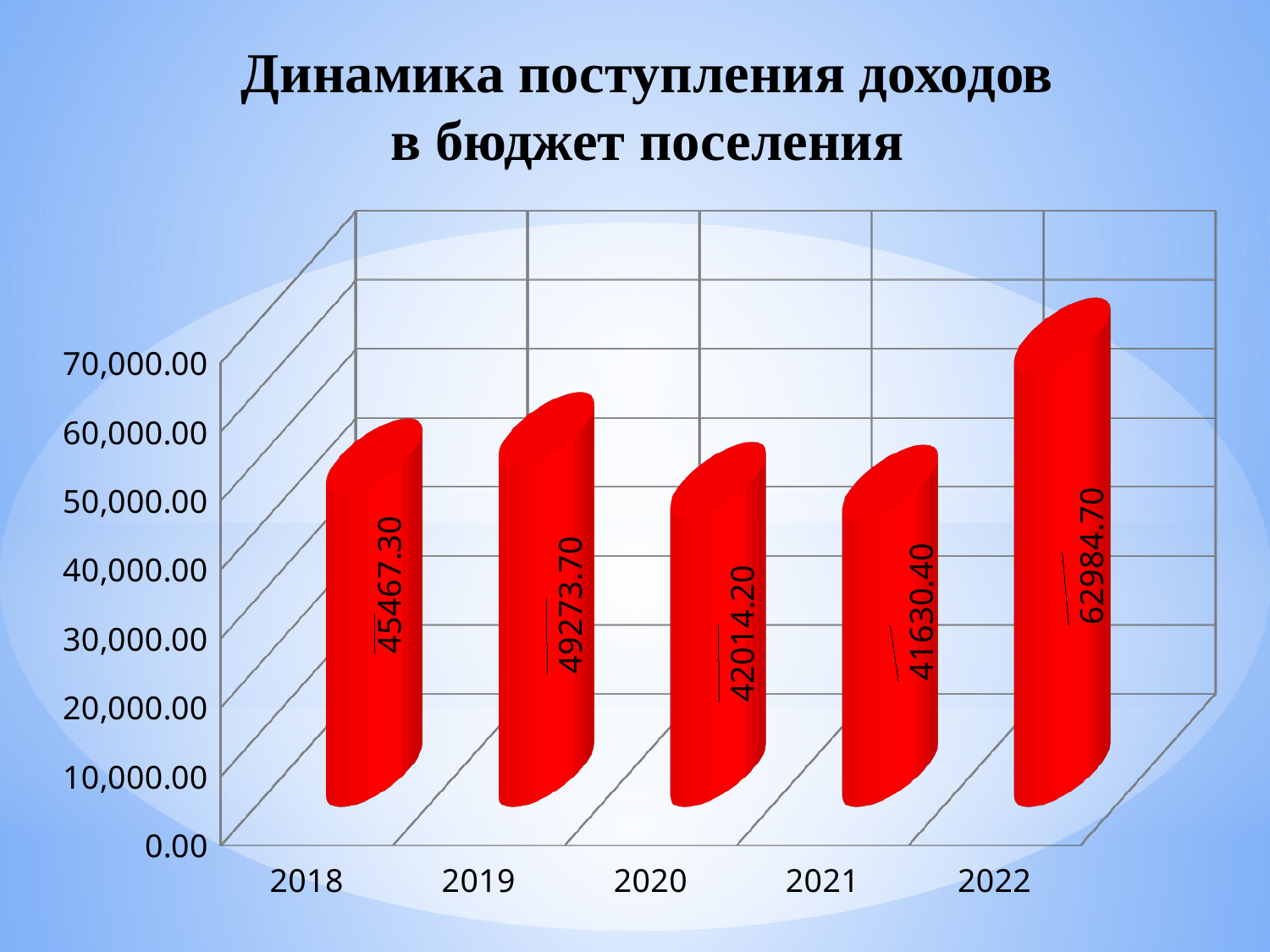
Between 2019 and 2021, do the values rise or fall? fall What is the difference between the values for 2022 and 2021? 21354.30 What is the value for 2022? 62984.70 What is the value for 2018? 45467.30 What is the difference between the values for 2019 and 2018? 3806.40 What kind of chart is shown on the slide? bar chart Which year has the lowest value? 2021 Which is larger, the value for 2019 or the value for 2020? 2019 How many years are shown on the x axis? 5 Is the value for 2022 greater or less than 60,000.00? greater What is the value for 2020? 42014.20 Which year has the highest value? 2022